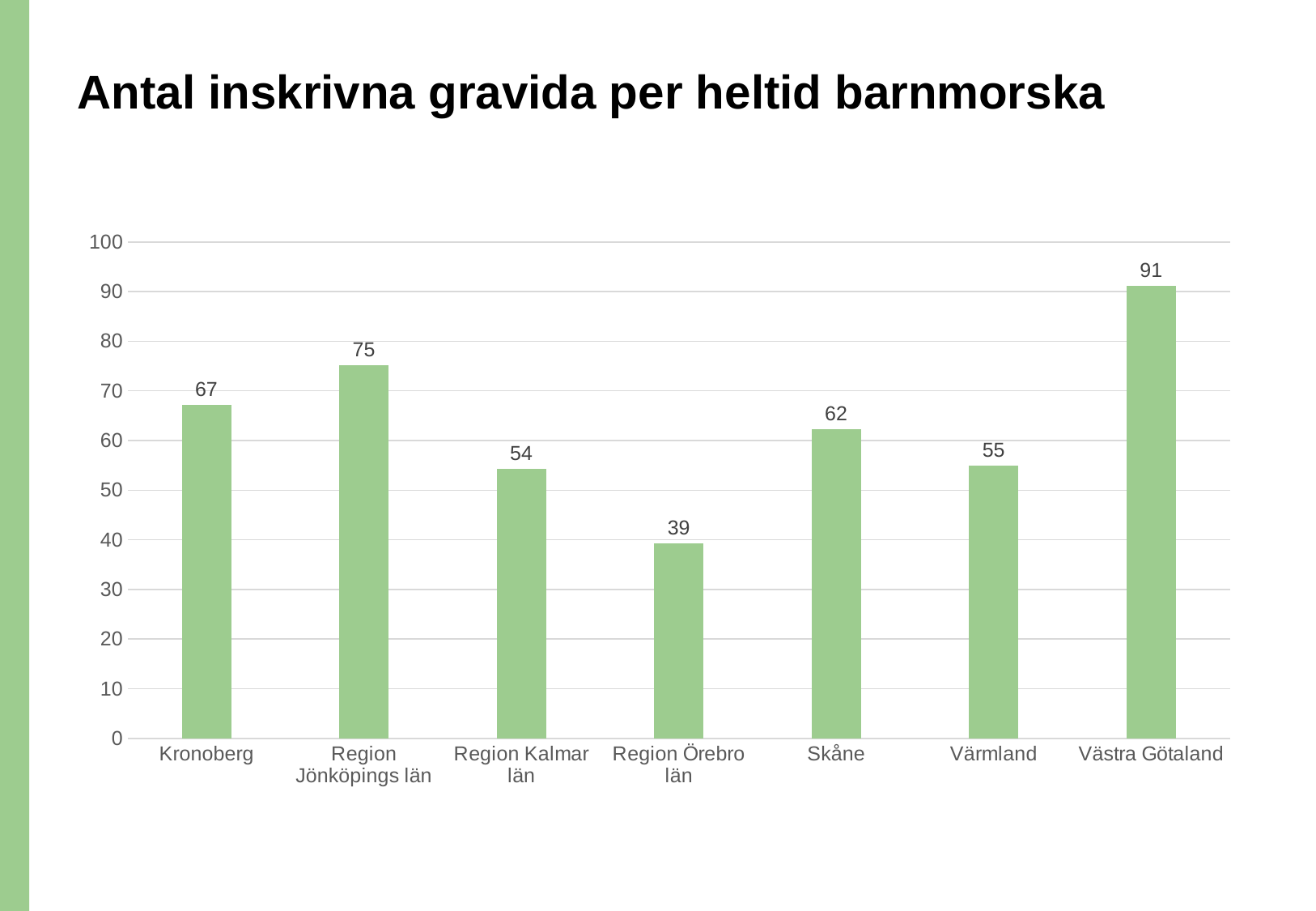
What is the value for Kronoberg? 67 How many regions are shown on the chart? 7 Which is larger, the value for Kronoberg or the value for Region Kalmar län? Kronoberg What is the title of the slide? Antal inskrivna gravida per heltid barnmorska What is the difference between the values for Västra Götaland and Region Örebro län? 52 What is the value for Värmland? 55 Which region has the lowest value? Region Örebro län What kind of chart is shown on the slide? bar chart What is the difference between the values for Region Jönköpings län and Skåne? 13 What is the value for Region Örebro län? 39 Which region has the highest value? Västra Götaland Is the value for Skåne greater or less than 50? greater